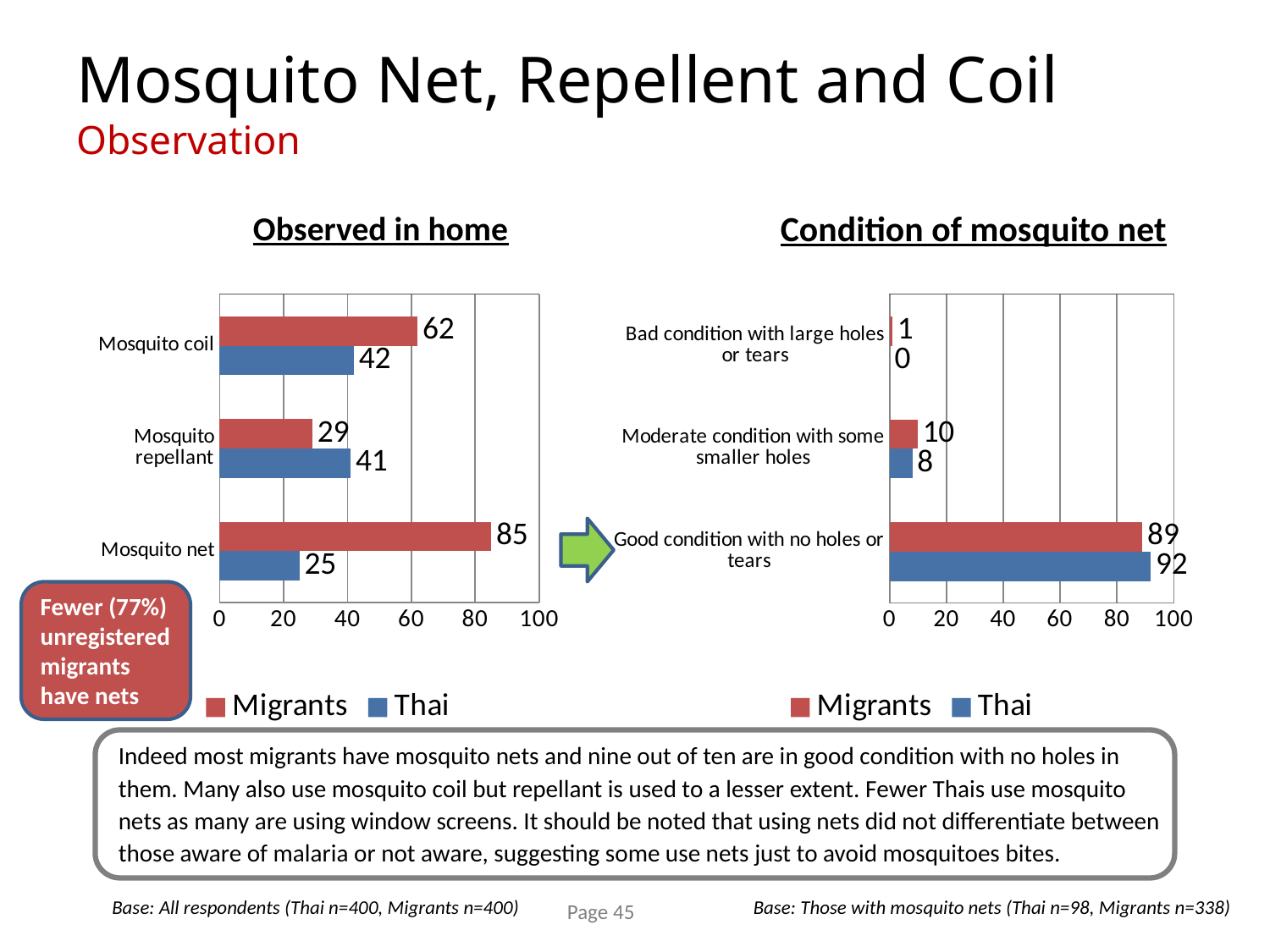
In the 'Condition of mosquito net' chart, what is the value for Migrants for 'Moderate condition with some smaller holes'? 10 How many categories are shown in the 'Condition of mosquito net' chart? 3 What type of chart is the 'Observed in home' chart? Bar chart In the 'Condition of mosquito net' chart, what is the difference between the Thai and Migrants values for 'Good condition with no holes or tears'? 3 How many series does the legend of the 'Observed in home' chart list? 2 In the 'Condition of mosquito net' chart, what is the value for Thai for 'Good condition with no holes or tears'? 92 In the 'Observed in home' chart, what is the difference between the Migrants and Thai values for Mosquito coil? 20 In the 'Observed in home' chart, which category has the highest value for Migrants? Mosquito net In the 'Observed in home' chart, what is the value for Migrants for Mosquito net? 85 In the 'Observed in home' chart, which category has the lowest value for Thai? Mosquito net In the 'Observed in home' chart, what is the value for Thai for Mosquito repellant? 41 In the 'Observed in home' chart, which is larger for Mosquito repellant, the Migrants value or the Thai value? Thai